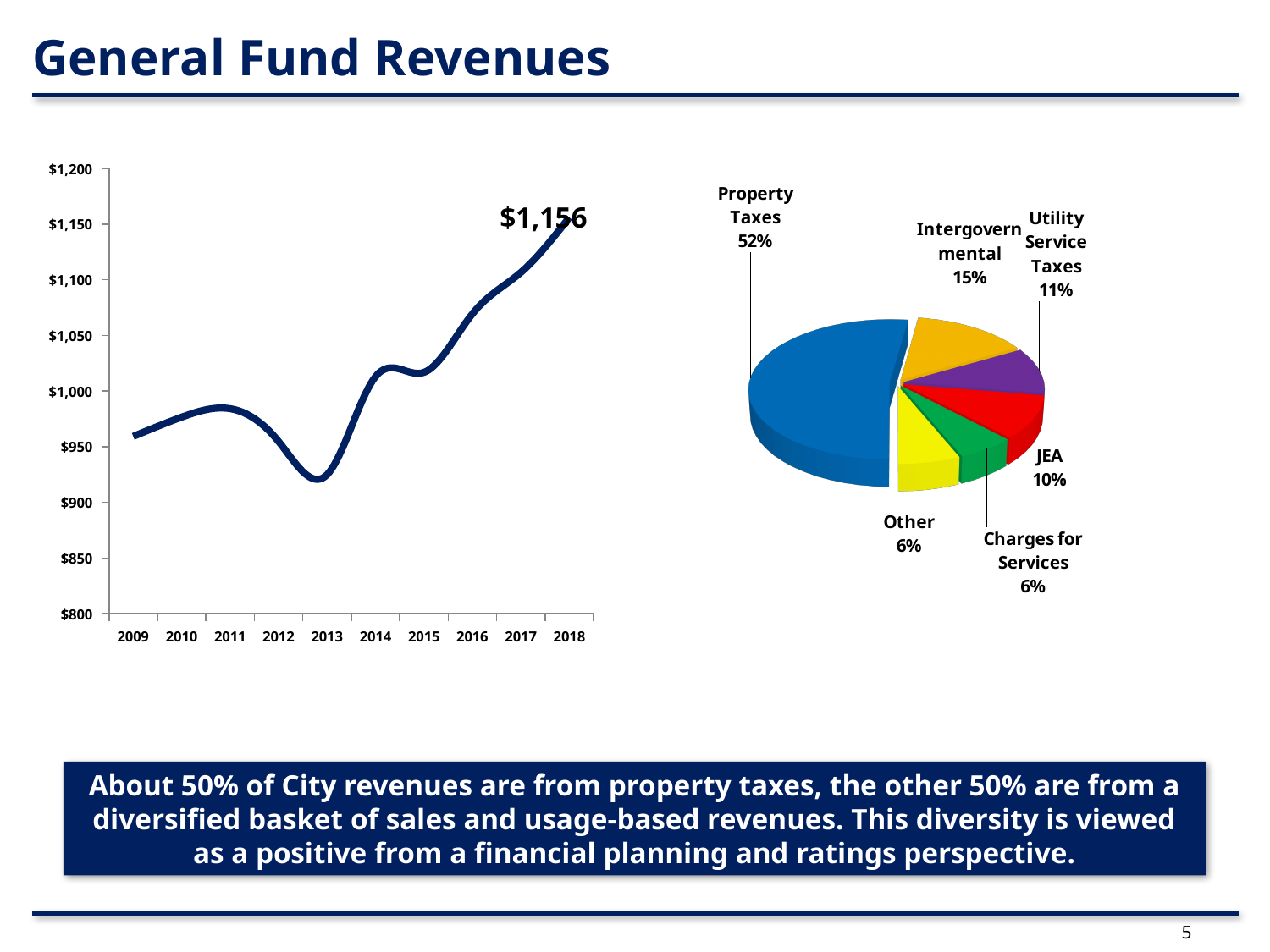
On the line chart on the left, what value is labelled for 2018? $1,156 On the line chart on the left, is the value for 2018 greater or less than $1,100? greater On the pie chart on the right, which category has the largest share? Property Taxes On the pie chart on the right, how many slices are there? 6 On the pie chart on the right, what share of revenues comes from Property Taxes? 52% On the line chart on the left, is the value for 2013 greater or less than $950? less What kind of chart is the chart on the left of the slide? line chart On the line chart on the left, do the values rise or fall between 2013 and 2018? rise On the line chart on the left, how many years are shown on the x axis? 10 What kind of chart is the chart on the right of the slide? pie chart On the pie chart on the right, which is larger, Intergovernmental or JEA? Intergovernmental On the line chart on the left, is the value for 2009 greater or less than $1,000? less